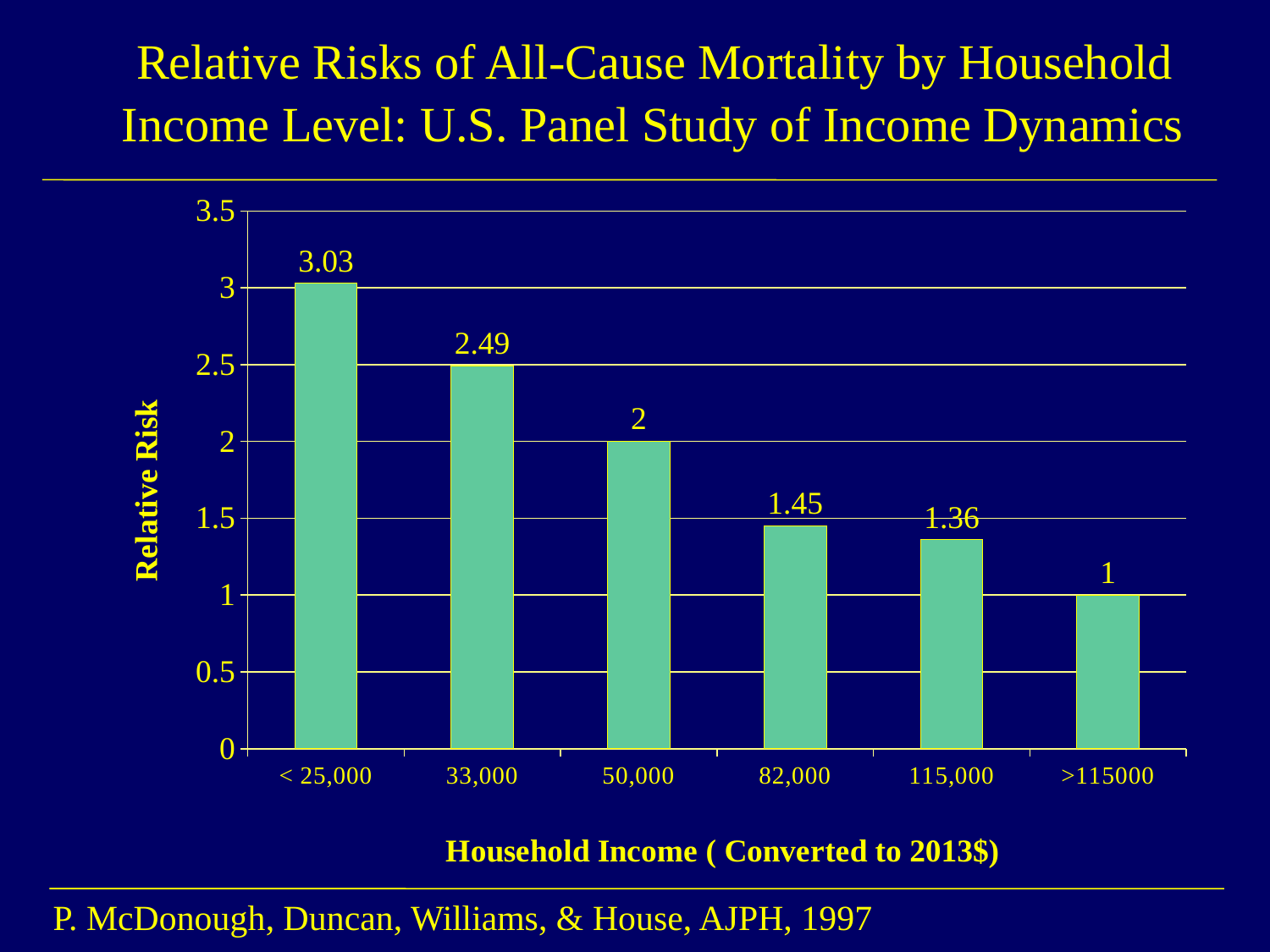
Which household income category has the highest relative risk? < 25,000 Which household income category has the lowest relative risk? >115000 What is the relative risk for the 115,000 household income category? 1.36 What is the relative risk for the 50,000 household income category? 2 What is the difference in relative risk between the < 25,000 and 33,000 categories? 0.54 Which has a larger relative risk, the 33,000 category or the 82,000 category? 33,000 How many household income categories are shown in the chart? 6 What kind of chart is shown on the slide? Bar chart Do the relative risk values rise or fall as household income increases along the x axis? Fall What is the difference in relative risk between the 82,000 and 115,000 categories? 0.09 What is the relative risk for the < 25,000 household income category? 3.03 Is the relative risk for the 33,000 category greater or less than 2.5? less